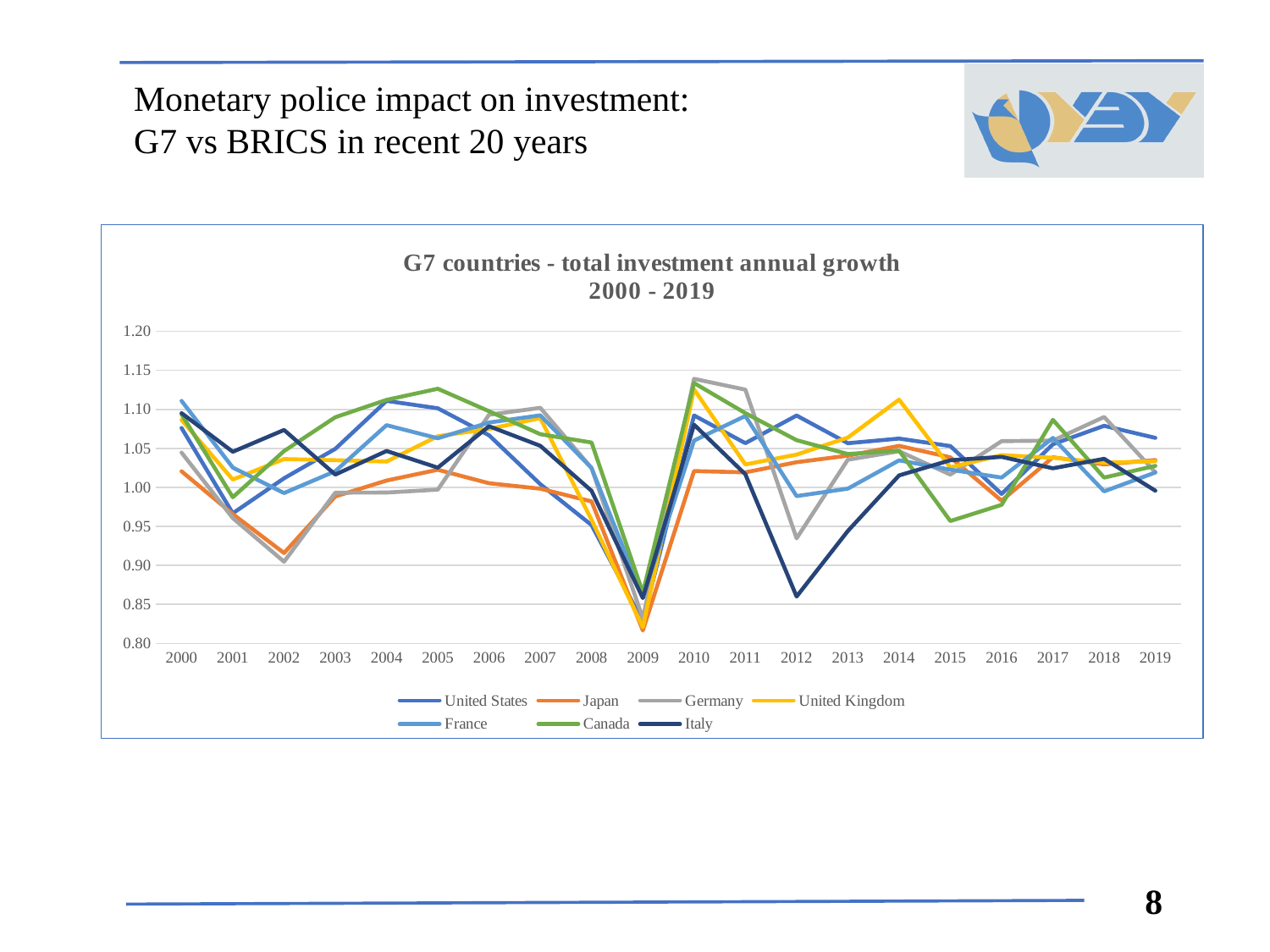
In 2012, which has the larger value, United States or Italy? United States What is the title of the chart? G7 countries - total investment annual growth 2000 - 2019 Is the value for Germany in 2010 greater or less than 1.10? greater How many years are plotted along the x axis of the chart? 20 In which year does the Japan line reach its lowest value? 2009 Is the value for Japan in 2009 greater or less than 0.85? less How many series does the legend of the chart list? 7 Is the value for Canada in 2015 greater or less than 1.00? less Does the Japan line rise or fall from 2008 to 2009? fall Which country is represented by the orange line in the chart? Japan What kind of chart is shown on the slide? line chart